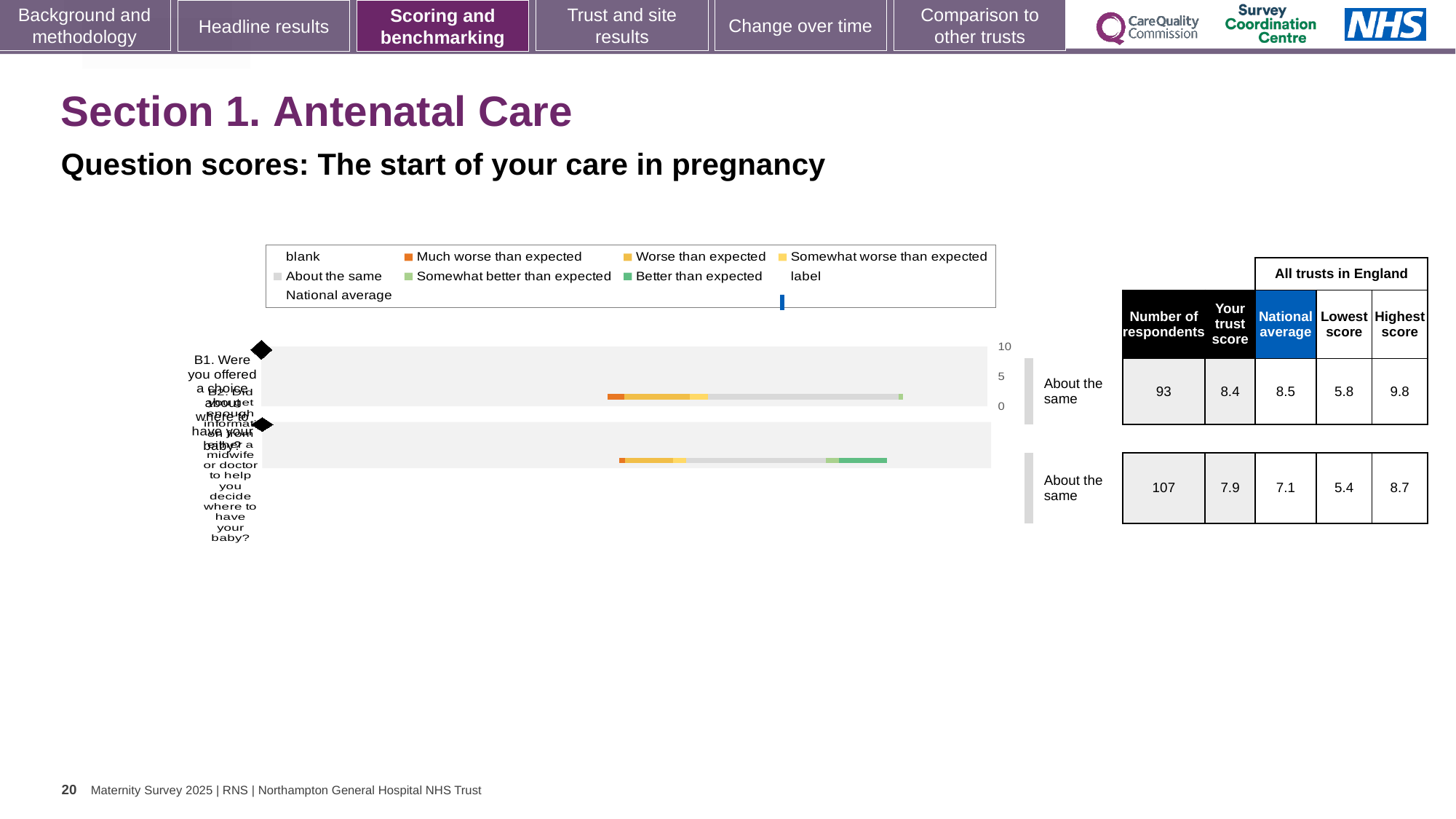
What benchmarking category is shown for question B2? About the same What is the trust score for question B1 (Were you offered a choice about where to have your baby?)? 8.4 What kind of chart is shown on the slide? bar chart For question B2, which is larger: the trust score or the national average? trust score For question B1, which is larger: the trust score or the national average? national average How many respondents answered question B1? 93 What is the difference between the highest score and the lowest score for question B1? 4.0 What is the highest score among all trusts in England for question B2? 8.7 What colour does the legend use for 'Better than expected'? green Which question has the higher trust score, B1 or B2? B1 What is the national average score for question B2? 7.1 How many questions (categories) are plotted in the chart? 2